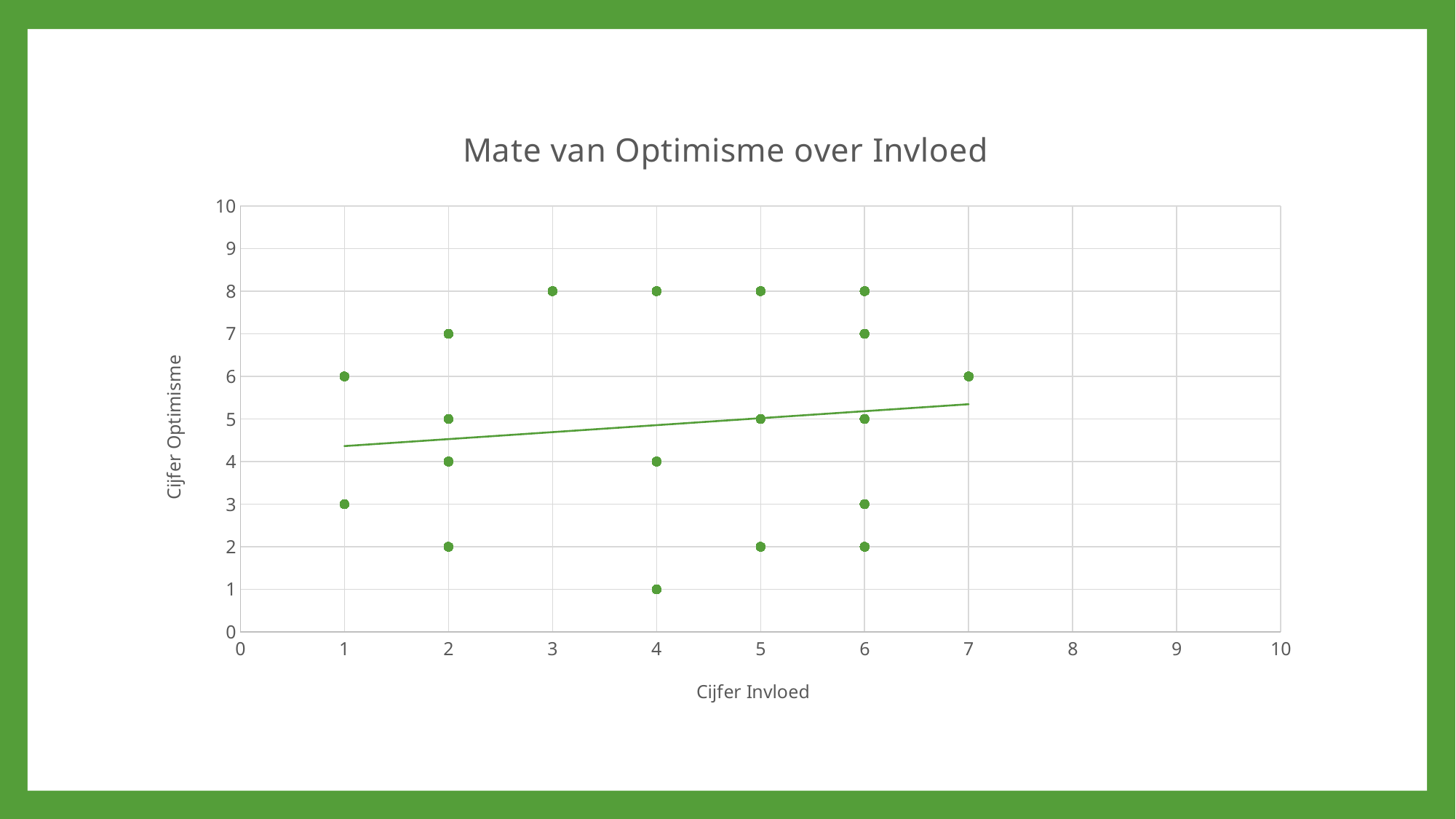
What is the lowest Cijfer Optimisme value reached by any point? 1 What is the highest Cijfer Optimisme value reached by any point? 8 What is the Cijfer Optimisme value of the single point at Cijfer Invloed 3? 8 What is the title of the chart? Mate van Optimisme over Invloed What is the Cijfer Invloed value of the point with the lowest Cijfer Optimisme? 4 What is the largest Cijfer Invloed value at which a point is plotted? 7 What is the Cijfer Optimisme value of the point at Cijfer Invloed 7? 6 What kind of chart is shown on the slide? Scatter chart Does the trendline rise or fall as Cijfer Invloed increases? Rises What is the label of the vertical axis? Cijfer Optimisme